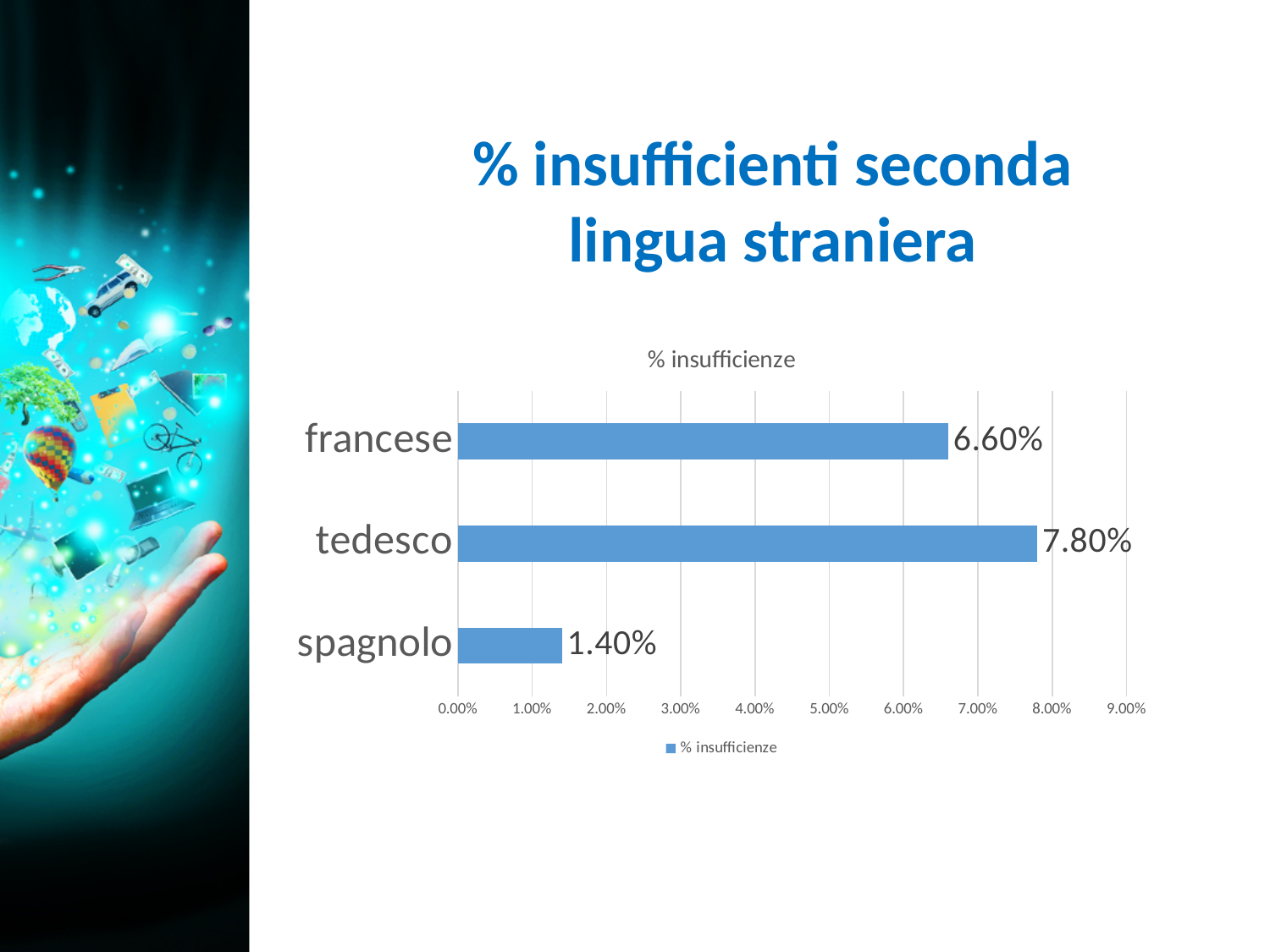
Which language has the highest percentage of insufficiencies? tedesco What is the title of the chart? % insufficienze What kind of chart is shown on the slide? bar chart Is the value for tedesco greater or less than 7.00%? greater What is the value for francese? 6.60% Which language has the lowest percentage of insufficiencies? spagnolo What is the value for tedesco? 7.80% Which is larger, the value for francese or the value for spagnolo? francese How many languages are shown in the chart? 3 What is the difference between the values for tedesco and francese? 1.20% What is the value for spagnolo? 1.40% What is the difference between the values for francese and spagnolo? 5.20%